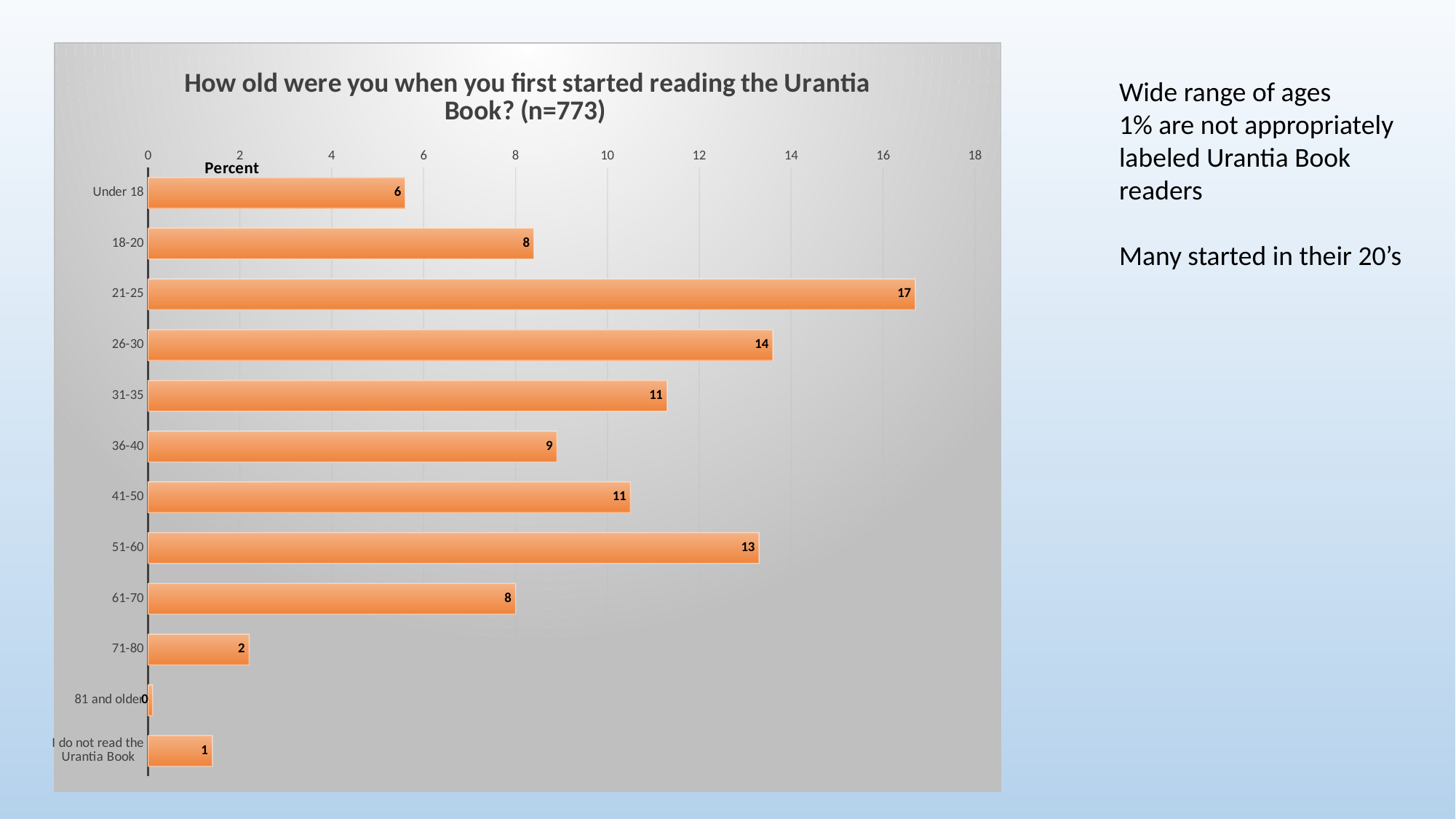
Which has a larger value, the 26-30 age group or the 36-40 age group? 26-30 What kind of chart is shown on the slide? Bar chart What is the difference between the values for the 21-25 and 26-30 age groups? 3 Is the value for the 51-60 age group greater or less than 12? greater How many categories are shown on the vertical axis of the chart? 12 What value is shown for the 'Under 18' category? 6 What is the label on the horizontal axis of the chart? Percent Which age group has the highest value in the chart? 21-25 What percentage of respondents first started reading the Urantia Book at age 21-25? 17 Which category has the lowest value in the chart? 81 and older What value is shown for the 51-60 age group? 13 What value is shown for the 'I do not read the Urantia Book' category? 1